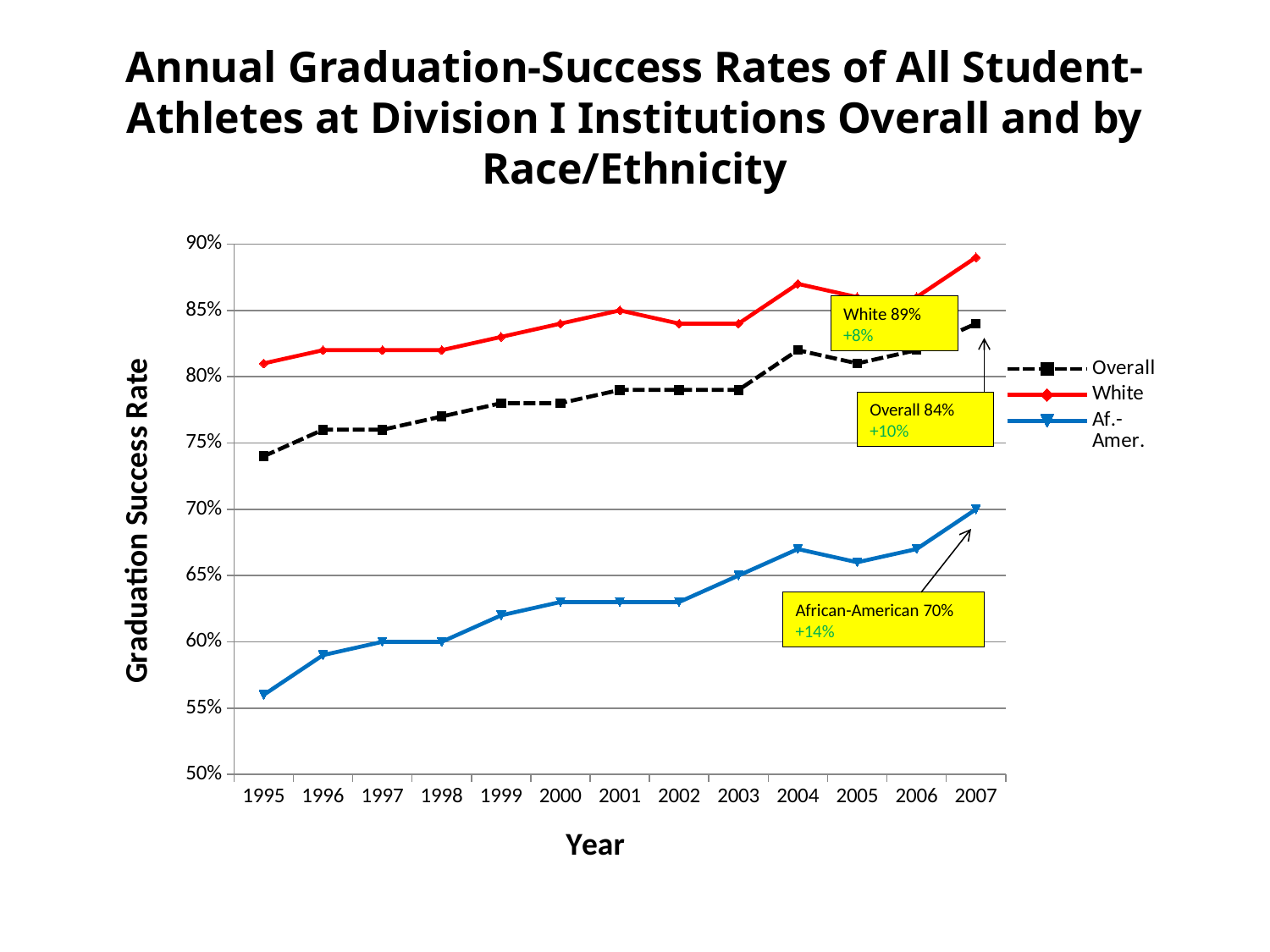
What type of chart is shown on the slide? line chart Does the African-American graduation success rate generally rise or fall from 1995 to 2007? rise What is the graduation success rate for African-American student-athletes in 2007? 70% How many years are plotted along the x axis? 13 What is the graduation success rate for White student-athletes in 2007? 89% Which series has the lowest graduation success rate across all years shown? Af.-Amer. Is the Overall graduation success rate in 1995 greater or less than 75%? less Which series has the highest graduation success rate in 2007? White What is the Overall graduation success rate in 2007? 84% What is the difference between the White and African-American graduation success rates in 2007? 19% How many series does the legend list? 3 According to the annotation, by how much did the African-American graduation success rate increase? +14%